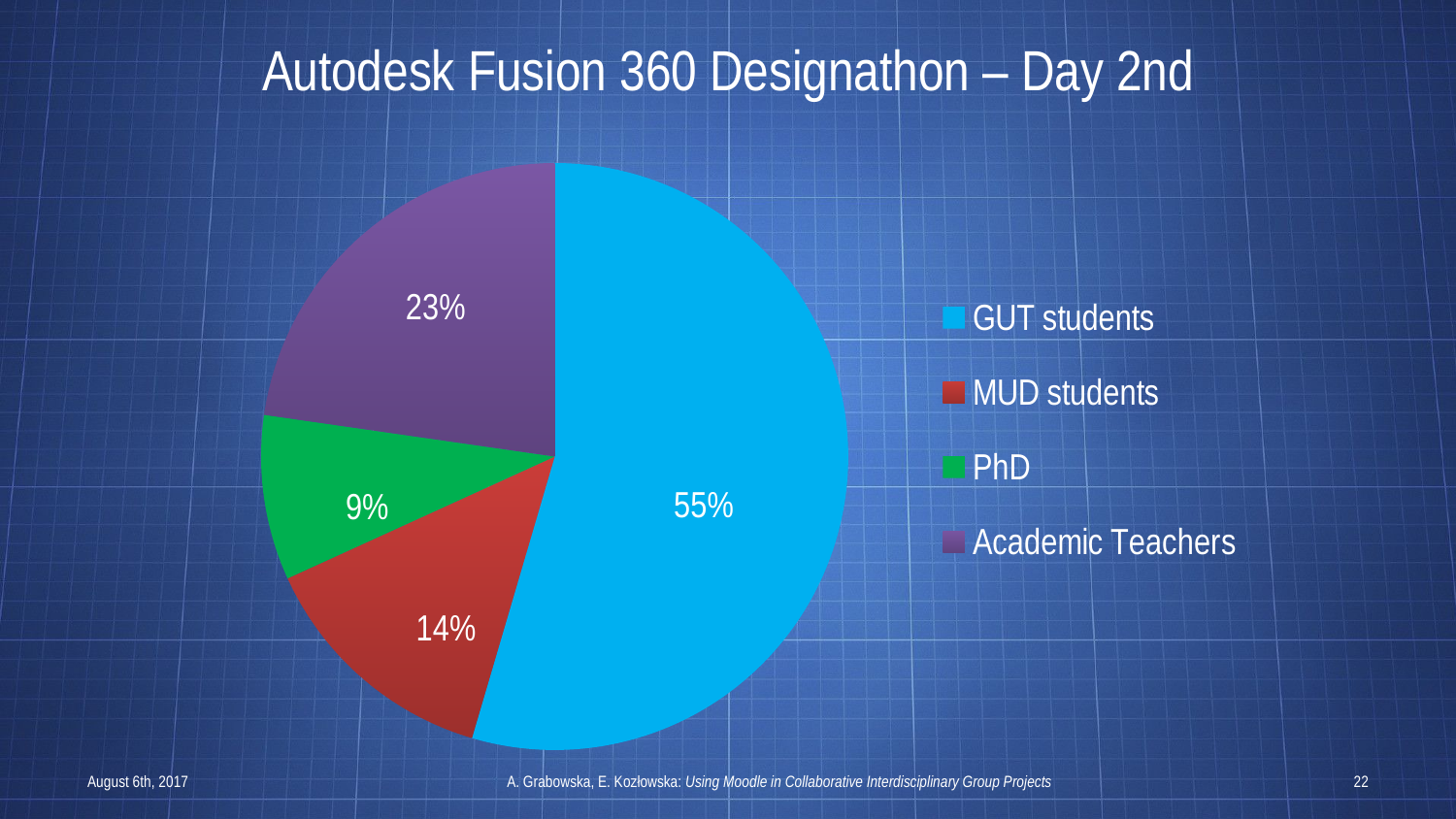
What is the title of the slide containing the chart? Autodesk Fusion 360 Designathon – Day 2nd What is the difference in percentage points between GUT students and Academic Teachers? 32 Which category has the smallest slice of the pie? PhD What colour is the slice for PhD in the pie chart? Green What share of the pie do GUT students represent? 55% How many categories does the pie chart show? 4 Which category has the largest slice of the pie? GUT students What kind of chart is shown on the slide? Pie chart What share of the pie do Academic Teachers represent? 23% What share of the pie do MUD students represent? 14% What share of the pie does the PhD slice represent? 9% Which is larger, the MUD students slice or the Academic Teachers slice? Academic Teachers